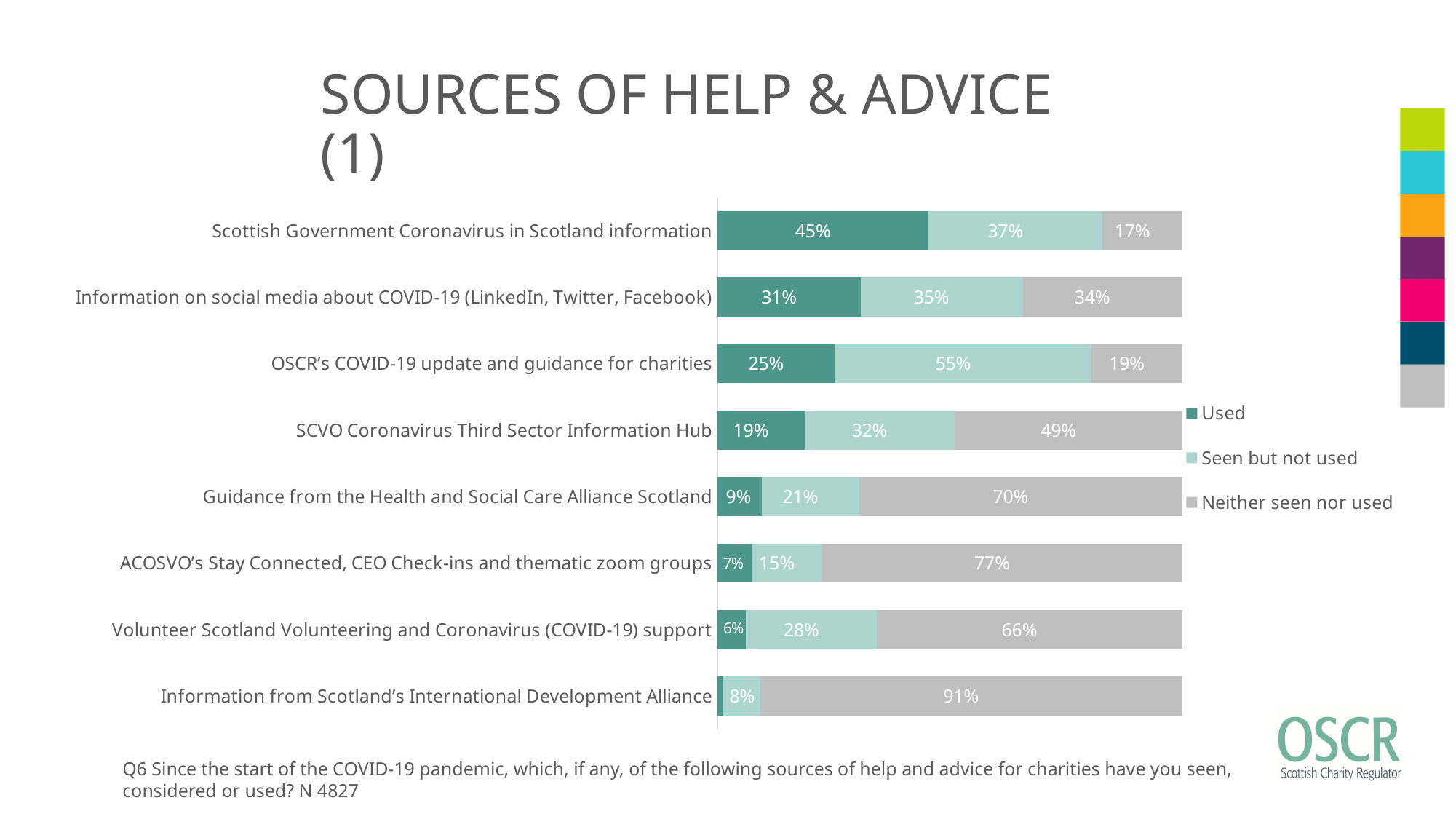
What percentage of respondents used the Scottish Government Coronavirus in Scotland information? 45% What kind of chart is shown on the slide? Stacked bar chart Which is larger: the 'Seen but not used' share for OSCR's COVID-19 update and guidance for charities or for SCVO Coronavirus Third Sector Information Hub? OSCR's COVID-19 update and guidance for charities What is the 'Used' percentage for ACOSVO's Stay Connected, CEO Check-ins and thematic zoom groups? 7% How many sources of help and advice are listed in the chart? 8 Which legend entry is shown in grey? Neither seen nor used How many series does the legend list? 3 What percentage had neither seen nor used Information from Scotland's International Development Alliance? 91% Which source has the highest 'Used' percentage? Scottish Government Coronavirus in Scotland information Which source has the lowest 'Neither seen nor used' percentage? Scottish Government Coronavirus in Scotland information What is the difference between the 'Used' percentages for Scottish Government Coronavirus in Scotland information and Information on social media about COVID-19? 14% What percentage had seen but not used OSCR's COVID-19 update and guidance for charities? 55%